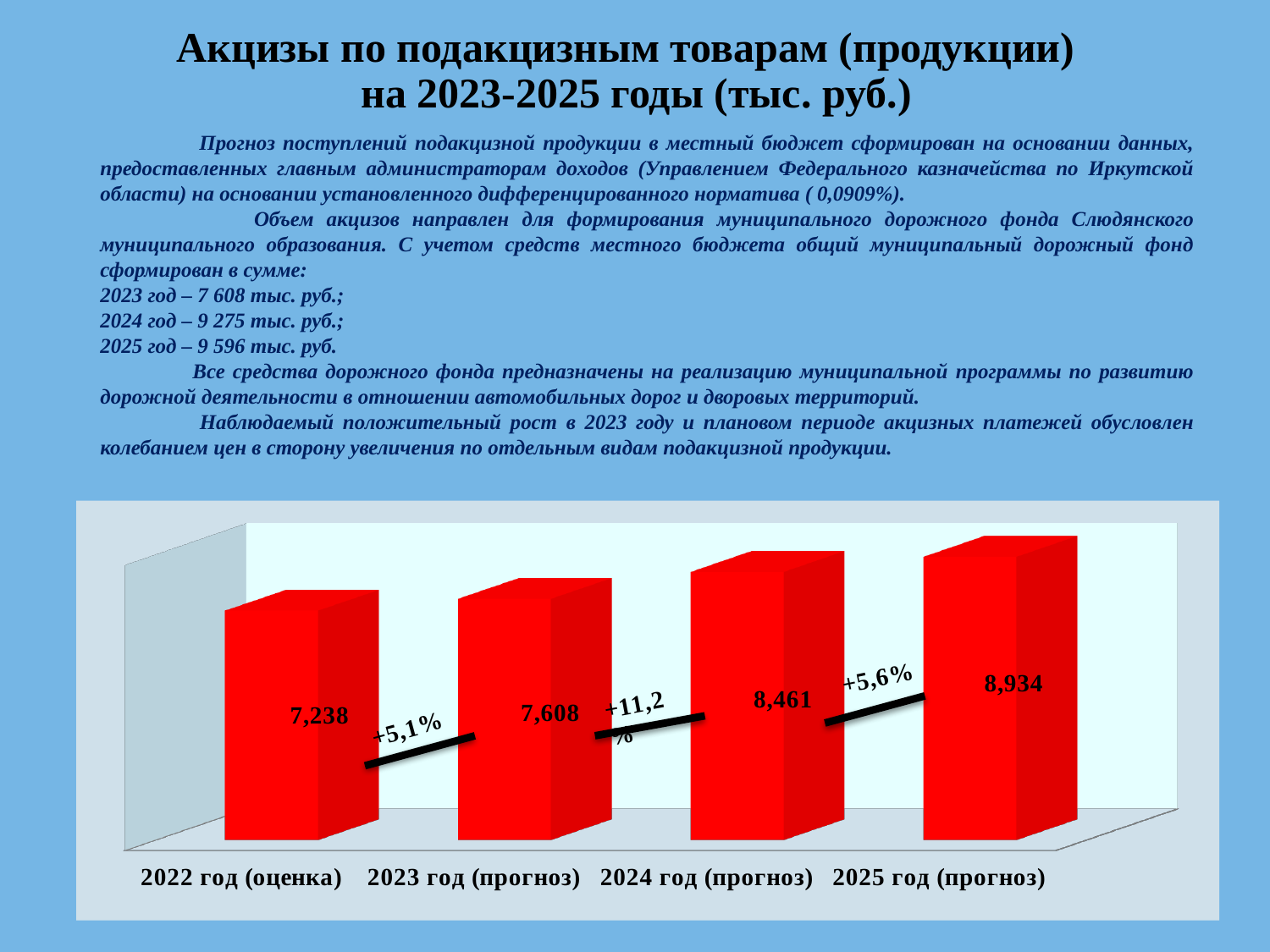
Which year has the lowest value? 2022 год (оценка) Do the values rise or fall from 2022 to 2025? rise Which year has the highest value? 2025 год (прогноз) What kind of chart is shown on the slide? bar chart What is the difference between the values for 2024 год (прогноз) and 2023 год (прогноз)? 853 What is the value for 2024 год (прогноз)? 8,461 What is the value for 2025 год (прогноз)? 8,934 What is the value for 2023 год (прогноз)? 7,608 What is the value for 2022 год (оценка)? 7,238 Which is larger, the value for 2023 год (прогноз) or 2024 год (прогноз)? 2024 год (прогноз) How many bars are shown in the chart? 4 What is the difference between the values for 2025 год (прогноз) and 2022 год (оценка)? 1,696